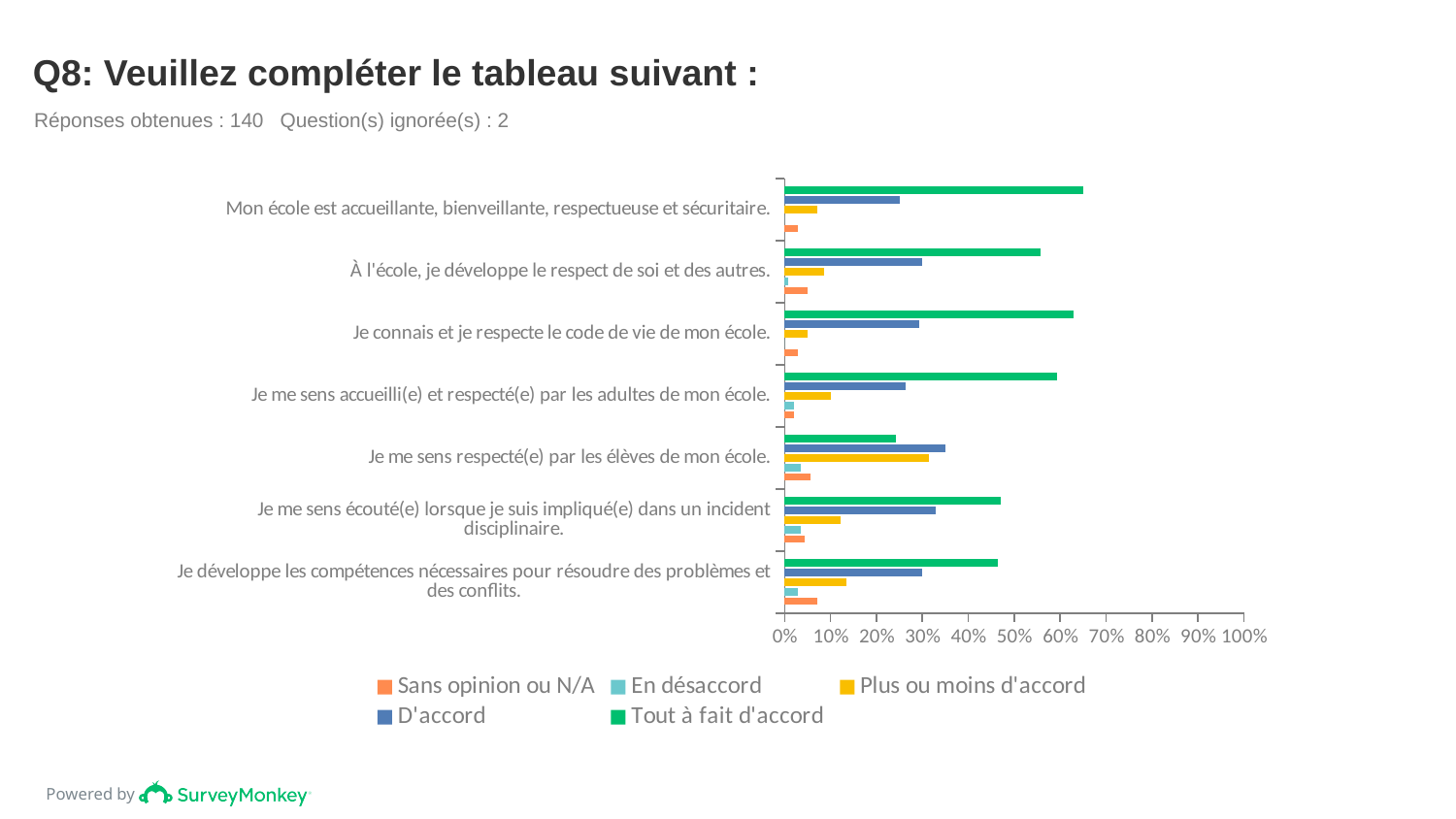
How many responses were obtained according to the slide? 140 How many statements (categories) are plotted on the chart? 7 What kind of chart is shown on the slide? Bar chart Which series is shown in green in the legend? Tout à fait d'accord Is the 'D'accord' value for 'Je me sens écouté(e) lorsque je suis impliqué(e) dans un incident disciplinaire.' greater or less than 30%? greater For 'Je me sens respecté(e) par les élèves de mon école.', which is larger: 'D'accord' or 'Tout à fait d'accord'? D'accord Is the 'Tout à fait d'accord' value for 'Je me sens respecté(e) par les élèves de mon école.' greater or less than 30%? less Is the 'Tout à fait d'accord' value for 'Mon école est accueillante, bienveillante, respectueuse et sécuritaire.' greater or less than 60%? greater Which is larger: the 'Tout à fait d'accord' value for 'Mon école est accueillante, bienveillante, respectueuse et sécuritaire.' or for 'Je développe les compétences nécessaires pour résoudre des problèmes et des conflits.'? Mon école est accueillante, bienveillante, respectueuse et sécuritaire. How many series does the legend list? 5 Which statement has the lowest 'Tout à fait d'accord' value? Je me sens respecté(e) par les élèves de mon école.